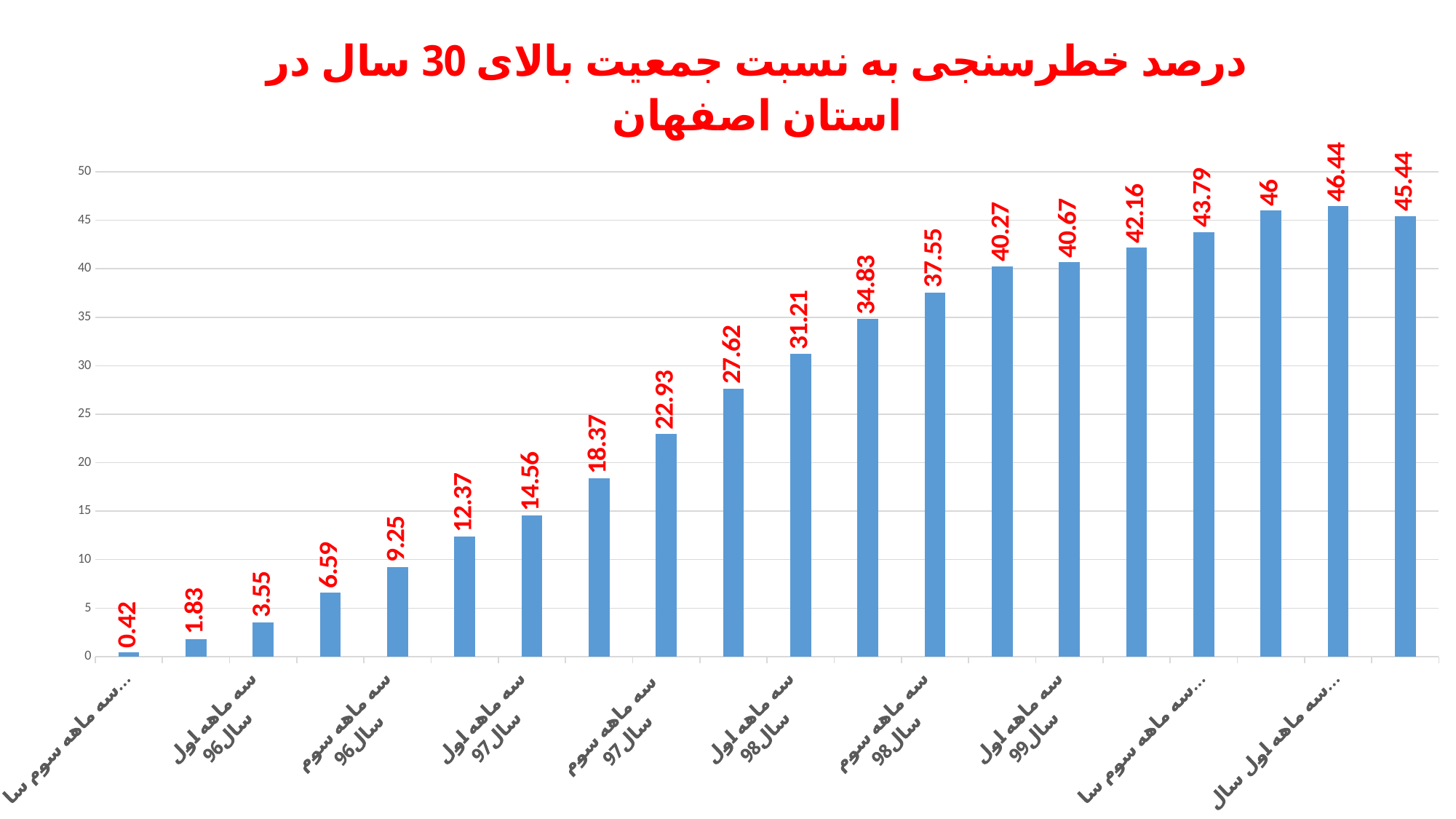
What is the value of the bar labelled سه ماهه اول سال 97? 14.56 What is the lowest value shown in the chart? 0.42 What is the highest value shown in the chart? 46.44 What is the value of the bar labelled سه ماهه اول سال 99? 40.67 What is the value of the bar labelled سه ماهه اول سال98? 31.21 What is the value of the bar labelled سه ماهه سوم سال96? 9.25 How many bars are plotted in the chart? 20 What is the difference between the values for سه ماهه سوم سال98 and سه ماهه اول سال98? 6.34 Do the values generally rise or fall from left to right along the x axis? rise What kind of chart is shown on the slide? bar chart What is the value of the bar labelled سه ماهه اول سال96? 3.55 Which is larger, the value for سه ماهه سوم سال 97 or the value for سه ماهه اول سال 97? سه ماهه سوم سال 97